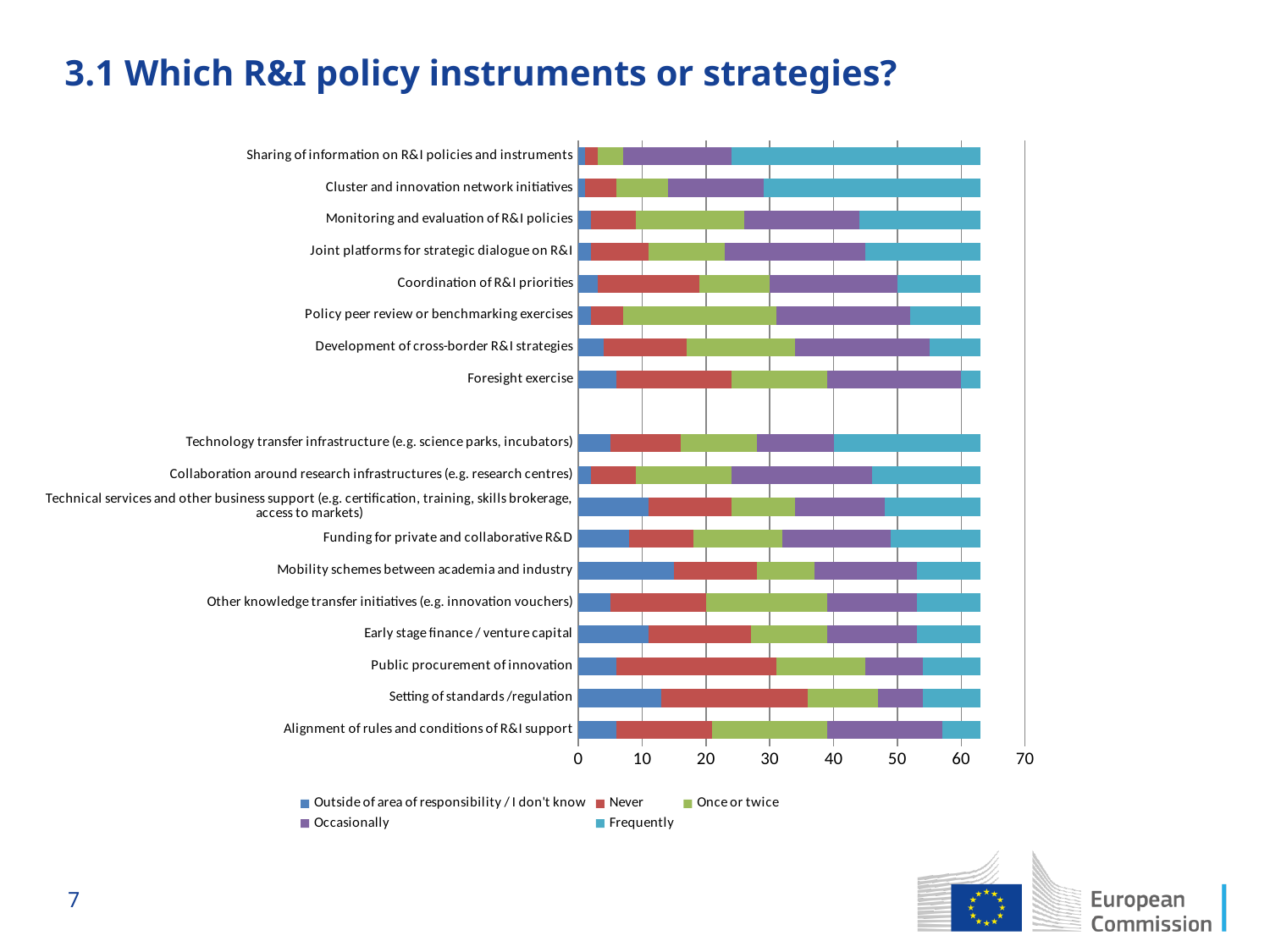
Which response category is shown in red in the legend? Never What is the title of the slide containing the chart? 3.1 Which R&I policy instruments or strategies? Is the 'Never' segment for 'Sharing of information on R&I policies and instruments' greater or less than 10? less Is the 'Frequently' segment for 'Sharing of information on R&I policies and instruments' greater or less than 30? greater How many series does the legend list? 5 Is the total bar length for 'Foresight exercise' greater or less than 60? greater Which category has the largest 'Frequently' segment? Sharing of information on R&I policies and instruments What kind of chart is shown on the slide? Stacked bar chart How many policy instruments or strategies (categories) are plotted on the chart? 18 Which has the larger 'Frequently' segment: 'Sharing of information on R&I policies and instruments' or 'Alignment of rules and conditions of R&I support'? Sharing of information on R&I policies and instruments Which has the larger 'Never' segment: 'Setting of standards /regulation' or 'Cluster and innovation network initiatives'? Setting of standards /regulation